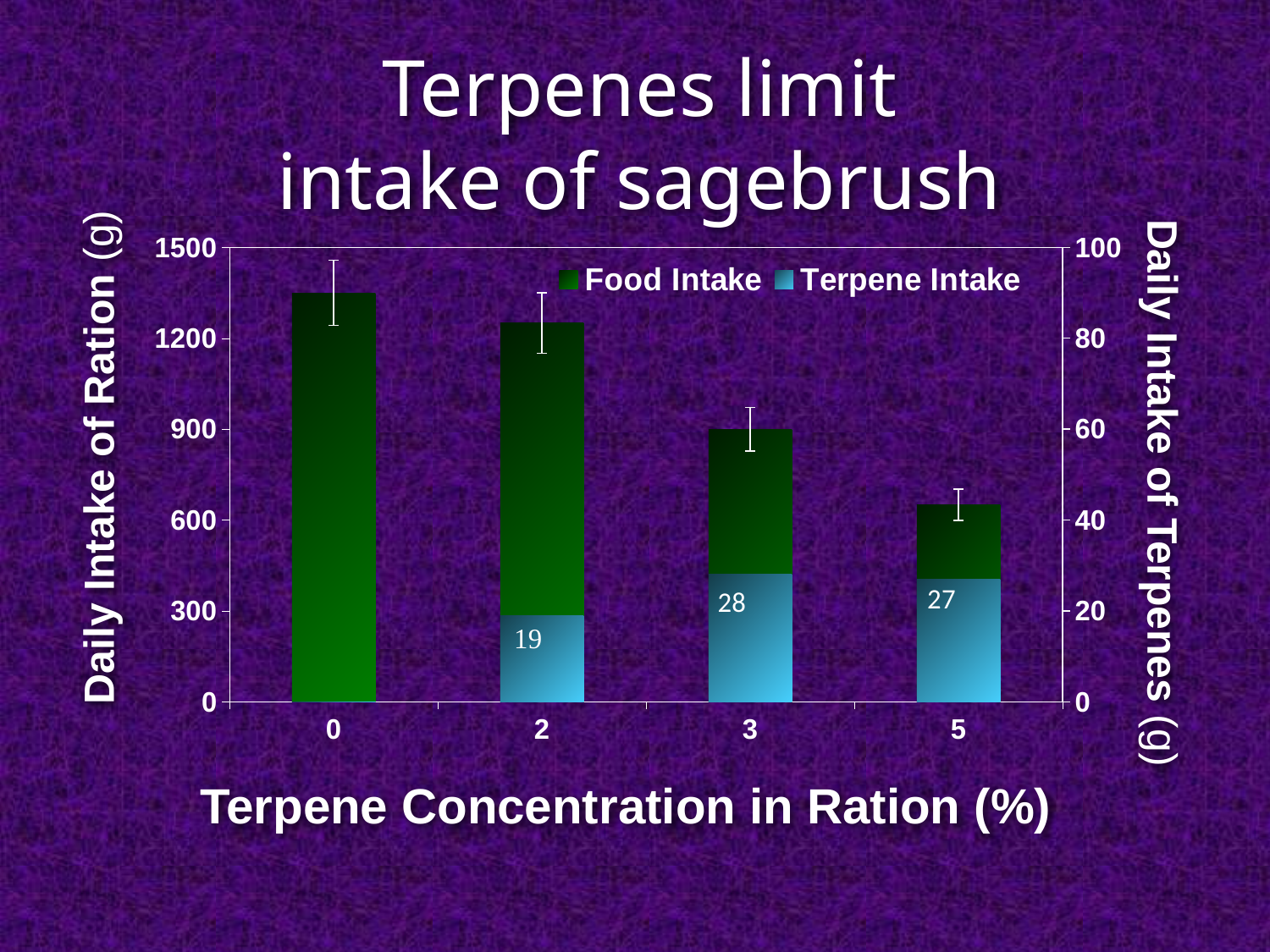
What is the Terpene Intake value at a terpene concentration of 2%? 19 Which terpene concentration has the larger Food Intake, 0% or 5%? 0 Is the Food Intake at 5% terpene concentration greater or less than 900? less How many series does the legend list? 2 What kind of chart is shown on the slide? bar chart Does Food Intake rise or fall as terpene concentration increases along the x axis? fall At which terpene concentration is Terpene Intake highest? 3 What is the difference between the Terpene Intake at 3% and at 2% concentration? 9 What is the Terpene Intake value at a terpene concentration of 5%? 27 Is the Food Intake at 0% terpene concentration greater or less than 1200? greater What is the Terpene Intake value at a terpene concentration of 3%? 28 How many terpene concentration categories are shown on the x axis? 4